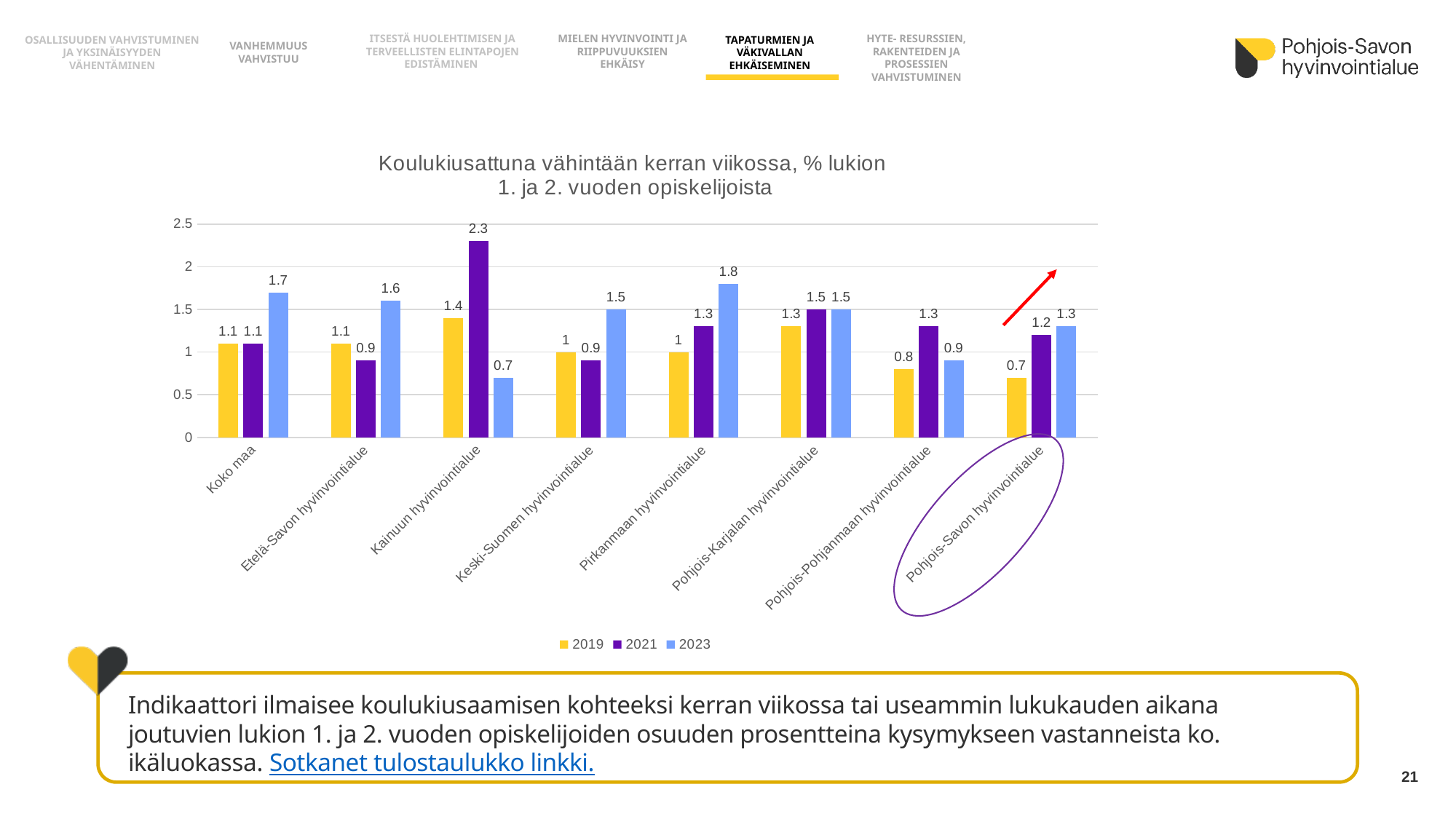
How many series does the legend list? 3 Which category has the lowest 2023 value? Kainuun hyvinvointialue Do the values for Pohjois-Savon hyvinvointialue rise or fall from 2019 to 2023? Rise What is the 2023 value for Pohjois-Savon hyvinvointialue? 1.3 What is the difference between the 2023 and 2019 values for Koko maa? 0.6 What is the 2019 value for Pohjois-Pohjanmaan hyvinvointialue? 0.8 Which is larger for Pirkanmaan hyvinvointialue, the 2019 value or the 2023 value? 2023 What kind of chart is shown on the slide? Bar chart Which category has the highest 2021 value? Kainuun hyvinvointialue What is the 2021 value for Kainuun hyvinvointialue? 2.3 How many categories are shown on the x axis? 8 What is the title of the chart? Koulukiusattuna vähintään kerran viikossa, % lukion 1. ja 2. vuoden opiskelijoista